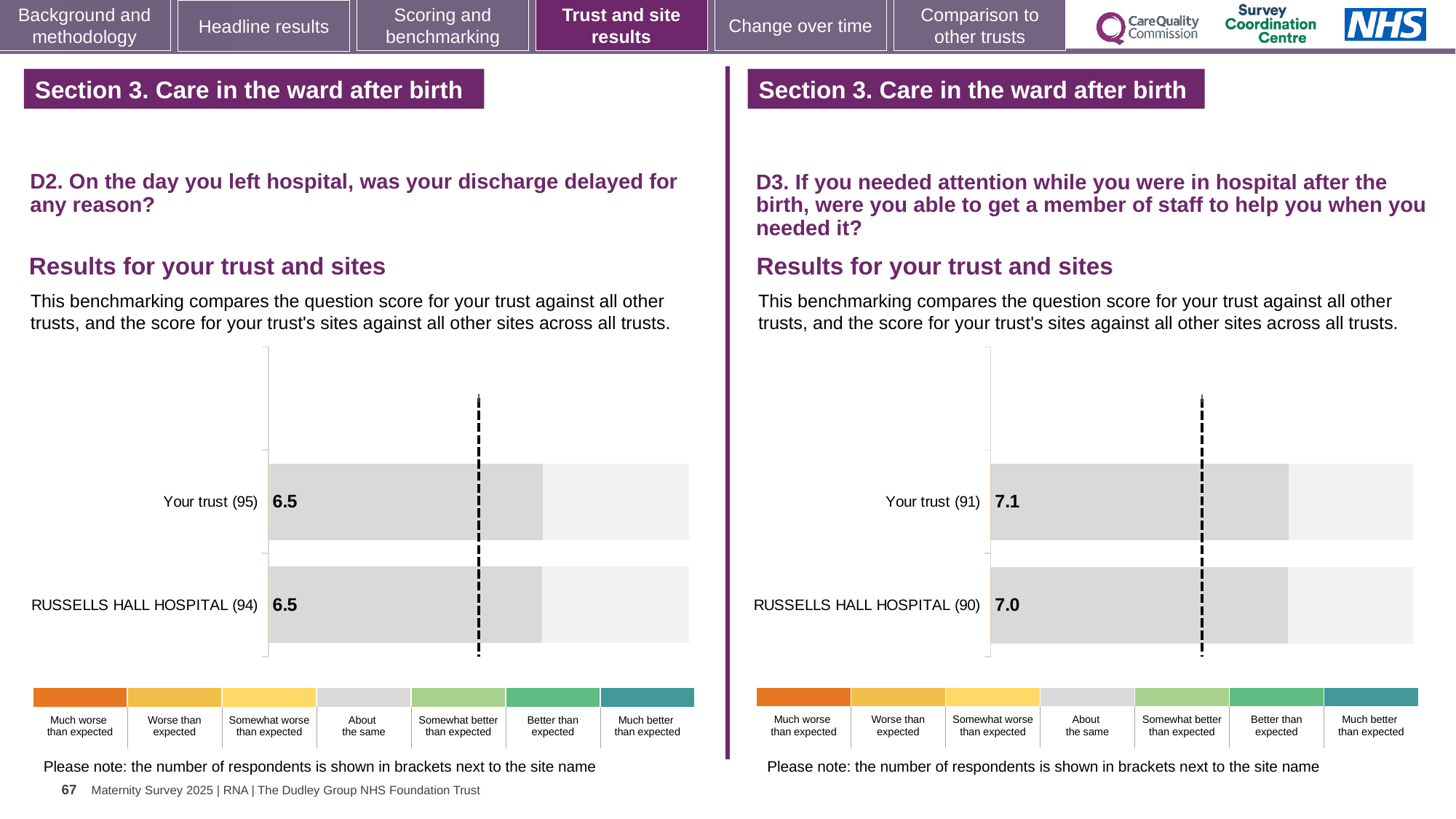
How many bars are plotted on the left chart (D2)? 2 On the left chart (D2), what is the score for RUSSELLS HALL HOSPITAL (94)? 6.5 How many bars are plotted on the right chart (D3)? 2 On the right chart (D3), how many respondents are shown in brackets for RUSSELLS HALL HOSPITAL? 90 On the right chart (D3), what is the difference between the score for Your trust (91) and RUSSELLS HALL HOSPITAL (90)? 0.1 What type of chart is used on the left (D2)? Bar chart On the left chart (D2), what is the difference between the score for Your trust (95) and RUSSELLS HALL HOSPITAL (94)? 0 What type of chart is used on the right (D3)? Bar chart On the right chart (D3), what is the score for Your trust (91)? 7.1 How many categories does the colour key below each chart list, from 'Much worse than expected' to 'Much better than expected'? 7 On the left chart (D2), what is the score for Your trust (95)? 6.5 On the right chart (D3), what is the score for RUSSELLS HALL HOSPITAL (90)? 7.0